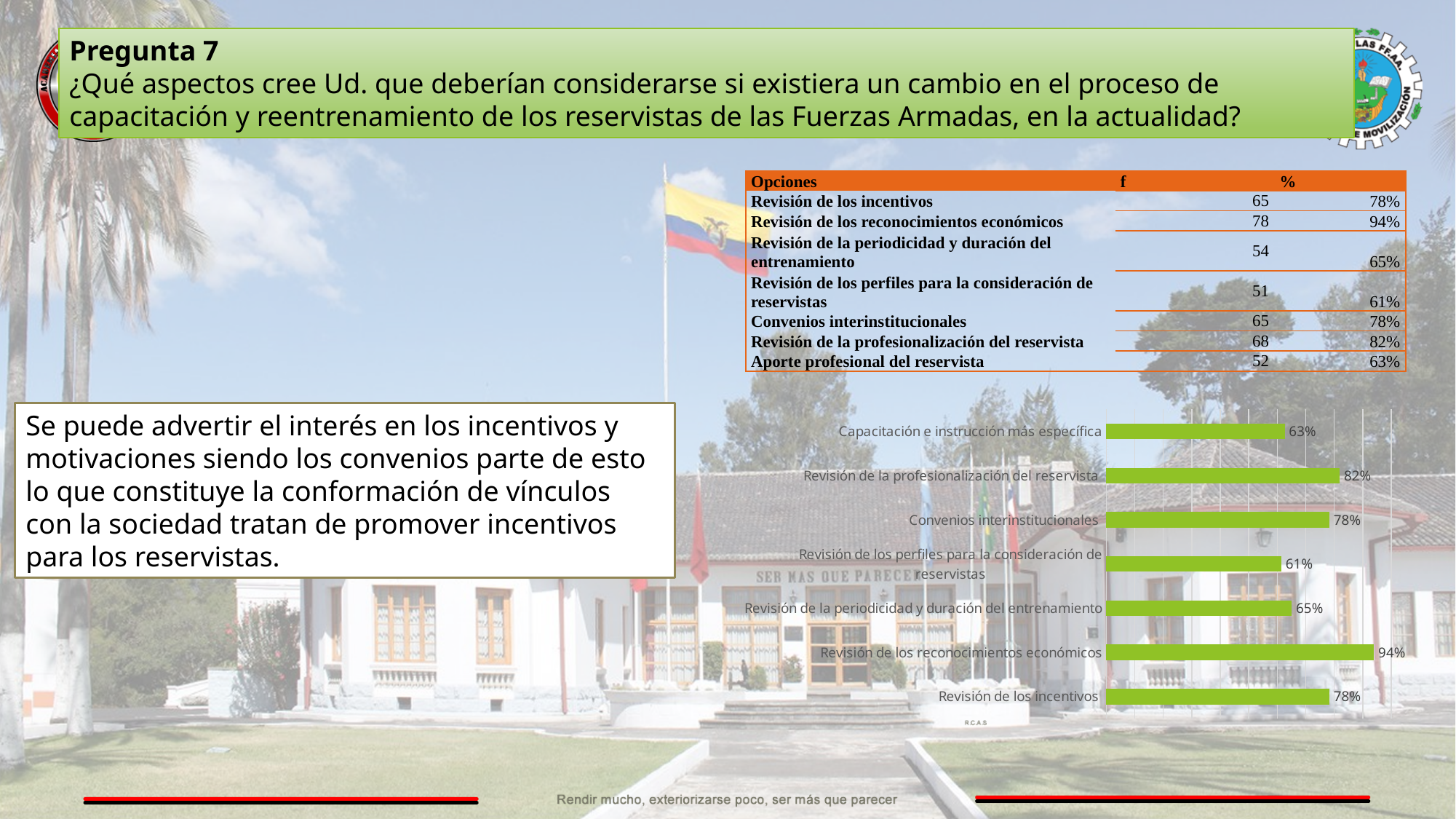
What colour are the bars in the chart? Green What is the difference between the values for Revisión de la profesionalización del reservista and Convenios interinstitucionales in the bar chart? 4% What is the value shown for Revisión de los reconocimientos económicos in the bar chart? 94% What is the value shown for Revisión de la profesionalización del reservista in the bar chart? 82% Which category has the highest value in the bar chart? Revisión de los reconocimientos económicos What is the value shown for Revisión de la periodicidad y duración del entrenamiento in the bar chart? 65% What kind of chart is shown on the slide? Bar chart What is the value shown for Capacitación e instrucción más específica in the bar chart? 63% How many categories are shown in the bar chart? 7 Which is larger in the bar chart: the value for Revisión de la profesionalización del reservista or the value for Capacitación e instrucción más específica? Revisión de la profesionalización del reservista What is the difference between the values for Revisión de los reconocimientos económicos and Revisión de los perfiles para la consideración de reservistas in the bar chart? 33% Which category has the lowest value in the bar chart? Revisión de los perfiles para la consideración de reservistas